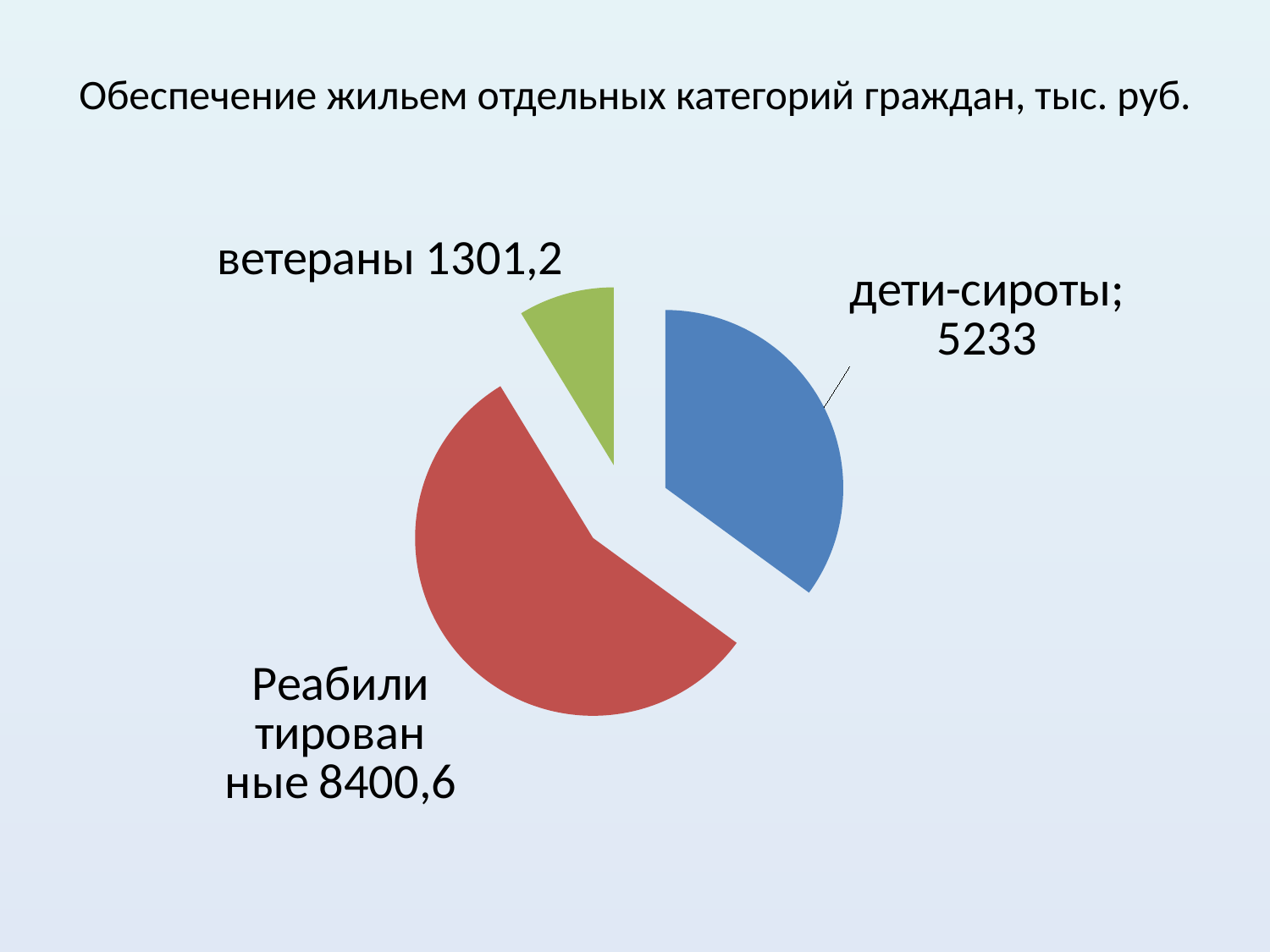
What is the value for дети-сироты in the pie chart? 5233 Which category has the largest slice of the pie chart? Реабилитированные What is the title of the chart on the slide? Обеспечение жильем отдельных категорий граждан, тыс. руб. What share of the pie does Реабилитированные represent? 56.2% What is the difference between the values for Реабилитированные and дети-сироты? 3167,6 What kind of chart is shown on the slide? Pie chart Which is larger, the value for дети-сироты or the value for ветераны? дети-сироты What is the value for Реабилитированные in the pie chart? 8400,6 What is the difference between the values for дети-сироты and ветераны? 3931,8 Which category has the smallest slice of the pie chart? ветераны How many categories are shown in the pie chart? 3 What is the value for ветераны in the pie chart? 1301,2